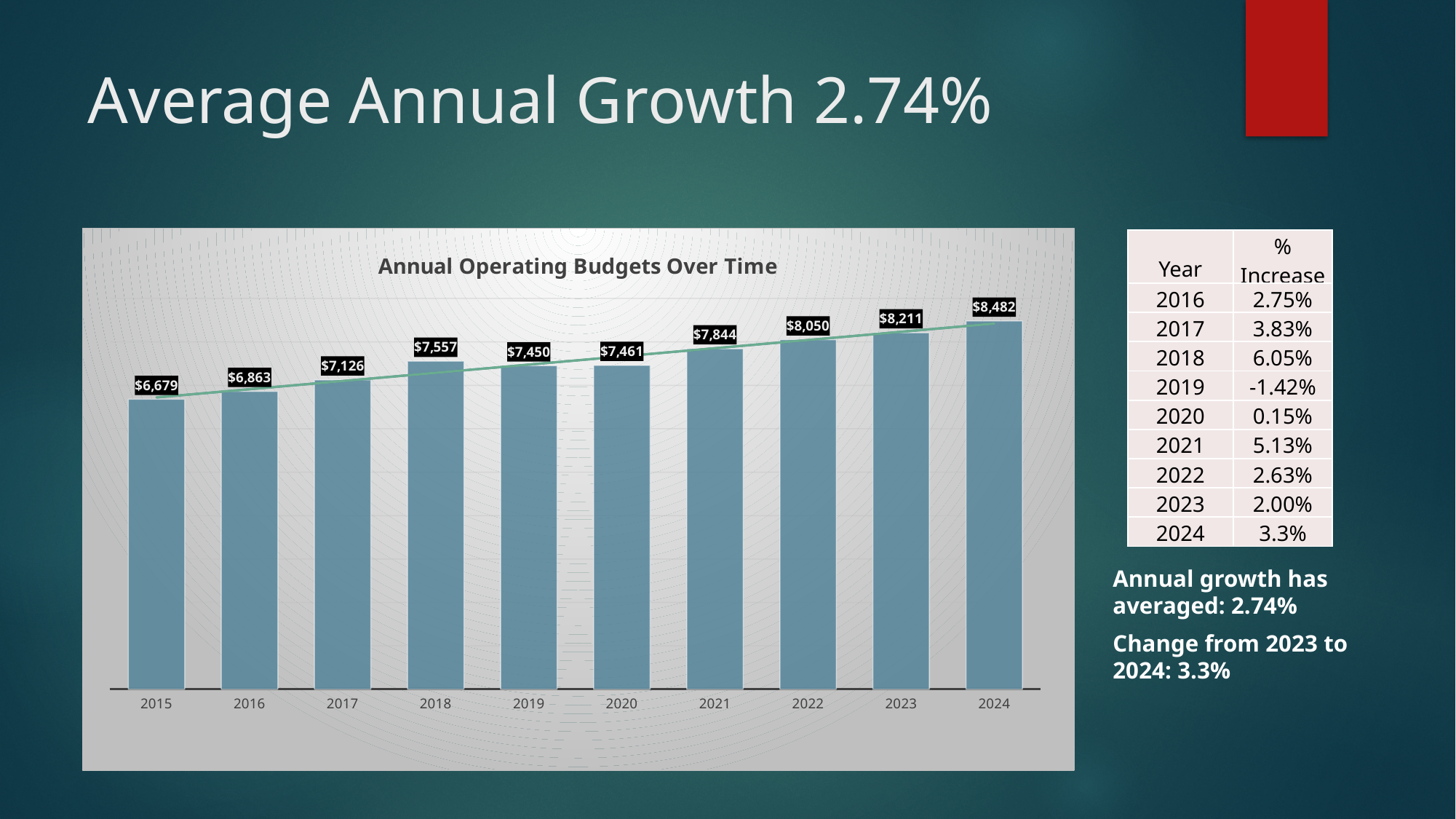
What is the difference between the 2024 and 2023 values in the Annual Operating Budgets Over Time chart? $271 Which year has the lowest value in the Annual Operating Budgets Over Time chart? 2015 Which year has the highest value in the Annual Operating Budgets Over Time chart? 2024 Do the values in the Annual Operating Budgets Over Time chart generally rise or fall from 2015 to 2024? Rise What kind of chart is the Annual Operating Budgets Over Time chart? Bar chart What is the value for 2020 in the Annual Operating Budgets Over Time chart? $7,461 What is the difference between the 2018 and 2019 values in the Annual Operating Budgets Over Time chart? $107 Which is larger in the Annual Operating Budgets Over Time chart, the value for 2018 or the value for 2019? 2018 What is the value for 2024 in the Annual Operating Budgets Over Time chart? $8,482 What is the value for 2015 in the Annual Operating Budgets Over Time chart? $6,679 What is the title of the chart on the slide? Annual Operating Budgets Over Time How many years are shown on the x axis of the Annual Operating Budgets Over Time chart? 10